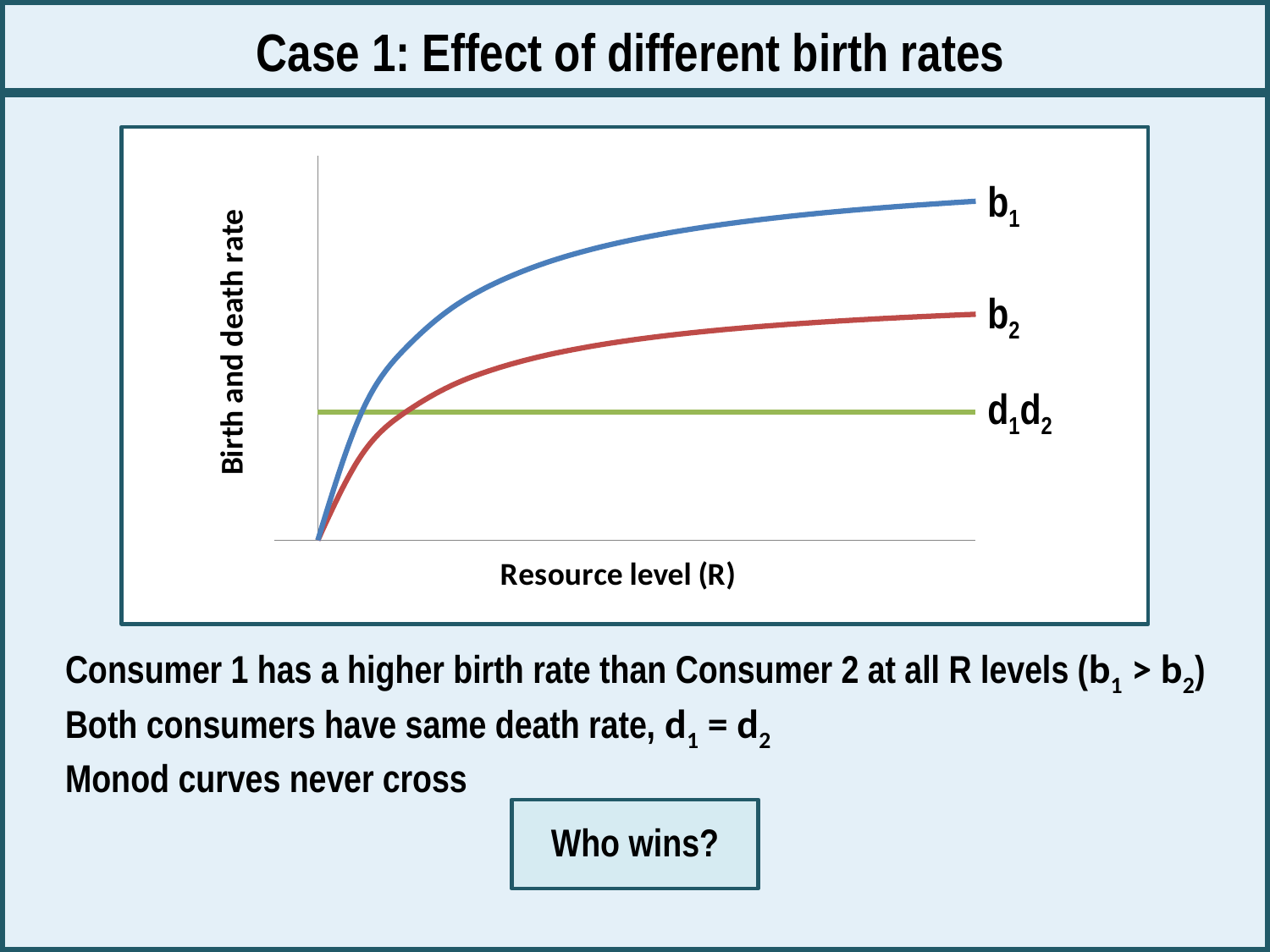
Does the b1 curve rise or fall as resource level (R) increases? Rises Which curve is higher at high resource levels, b1 or b2? b1 How many curves are plotted on the chart? 3 What is the label of the x axis? Resource level (R) Which curve reaches the highest birth rate on the chart? b1 What is the label of the y axis? Birth and death rate Which curve crosses the d1d2 line at a lower resource level, b1 or b2? b1 Does the b2 curve rise or fall as resource level (R) increases? Rises Does the d1d2 line rise, fall, or stay flat as resource level (R) increases? Stays flat What kind of chart is shown on the slide? Line chart Which of the three plotted lines is lowest at the right-hand end of the chart? d1d2